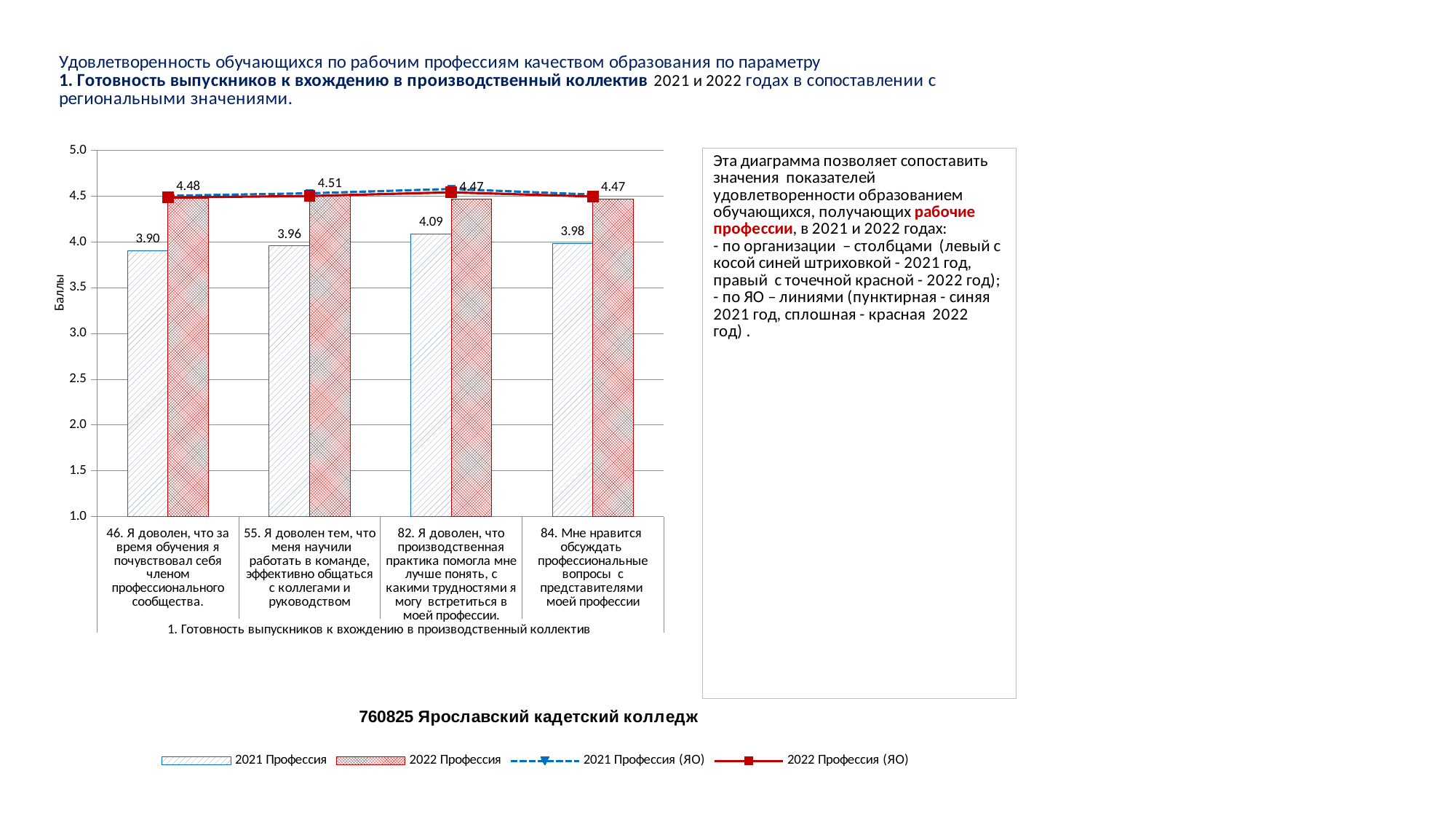
How many categories (questions) are shown on the x axis of the chart? 4 Which category has the highest 2021 Профессия value? 82. Я доволен, что производственная практика помогла мне лучше понять, с какими трудностями я могу встретиться в моей профессии. How many series does the chart legend list? 4 What is the value of the 2022 Профессия bar for category 84 (Мне нравится обсуждать профессиональные вопросы)? 4.47 What is the value of the 2021 Профессия bar for category 46 (Я доволен, что за время обучения я почувствовал себя членом профессионального сообщества)? 3.90 Which category has the lowest 2021 Профессия value? 46. Я доволен, что за время обучения я почувствовал себя членом профессионального сообщества. Which category has the highest 2022 Профессия value? 55. Я доволен тем, что меня научили работать в команде, эффективно общаться с коллегами и руководством What is the value of the 2021 Профессия bar for category 82 (производственная практика помогла мне лучше понять)? 4.09 What is the difference between the 2022 Профессия and 2021 Профессия values for category 46? 0.58 For category 84, which is larger: the 2021 Профессия value or the 2022 Профессия value? 2022 Профессия What is the value of the 2022 Профессия bar for category 55 (Я доволен тем, что меня научили работать в команде)? 4.51 What is the label of the vertical axis of the chart? Баллы